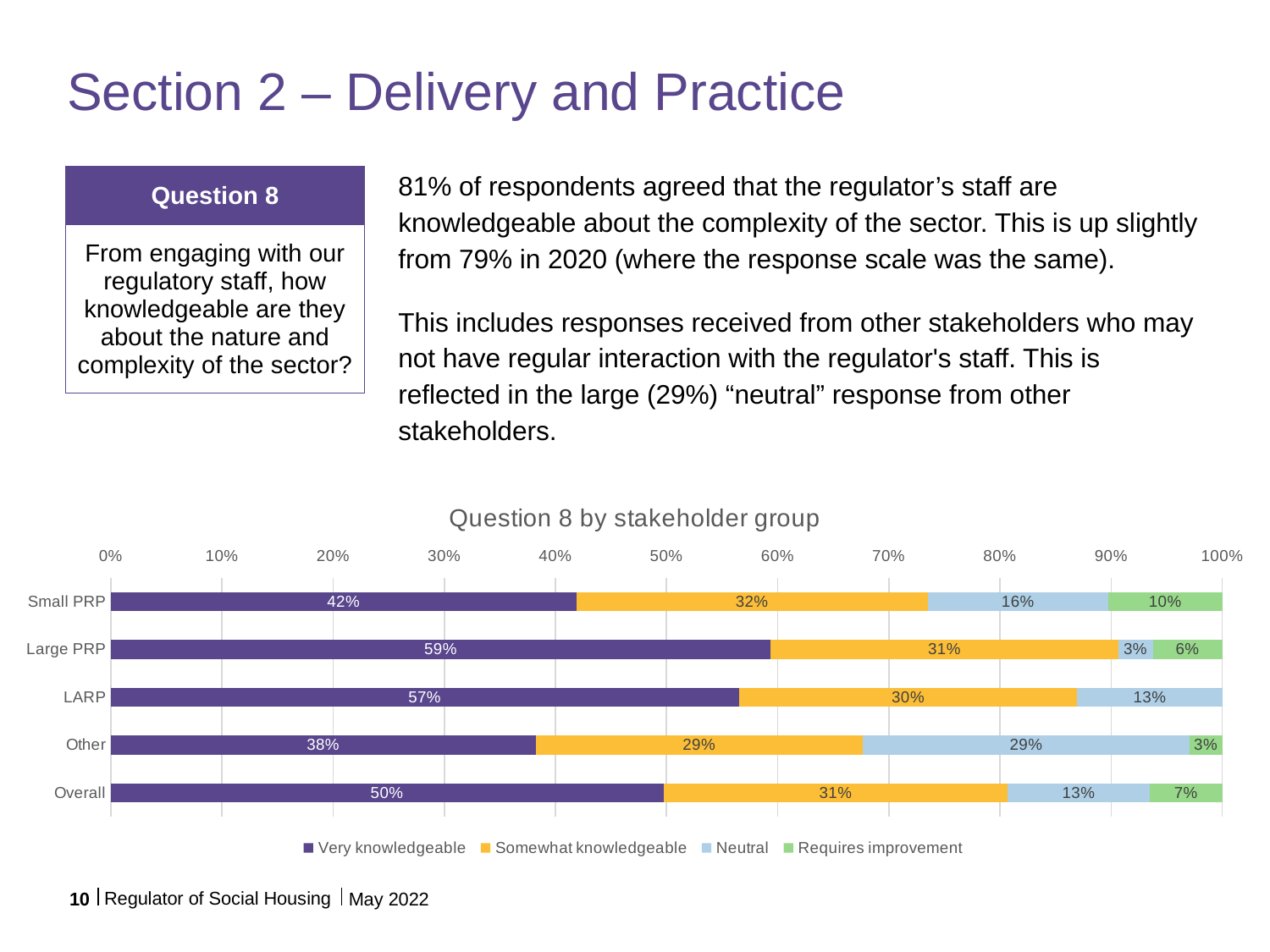
How many stakeholder groups are plotted in the chart? 5 What is the "Neutral" value for Other? 29% What is the "Requires improvement" value for Overall? 7% Which stakeholder group has the lowest "Very knowledgeable" value? Other What type of chart is shown under the title "Question 8 by stakeholder group"? Stacked bar chart What is the "Very knowledgeable" value for Large PRP? 59% Which stakeholder group has the highest "Very knowledgeable" value? Large PRP Which is larger: the "Neutral" value for Small PRP or the "Neutral" value for Large PRP? Small PRP What is the difference between the "Very knowledgeable" values for Large PRP and Small PRP? 17% What is the combined "Very knowledgeable" and "Somewhat knowledgeable" value for Overall? 81% How many series does the chart legend list? 4 Which series is shown in the dark purple colour in the chart? Very knowledgeable